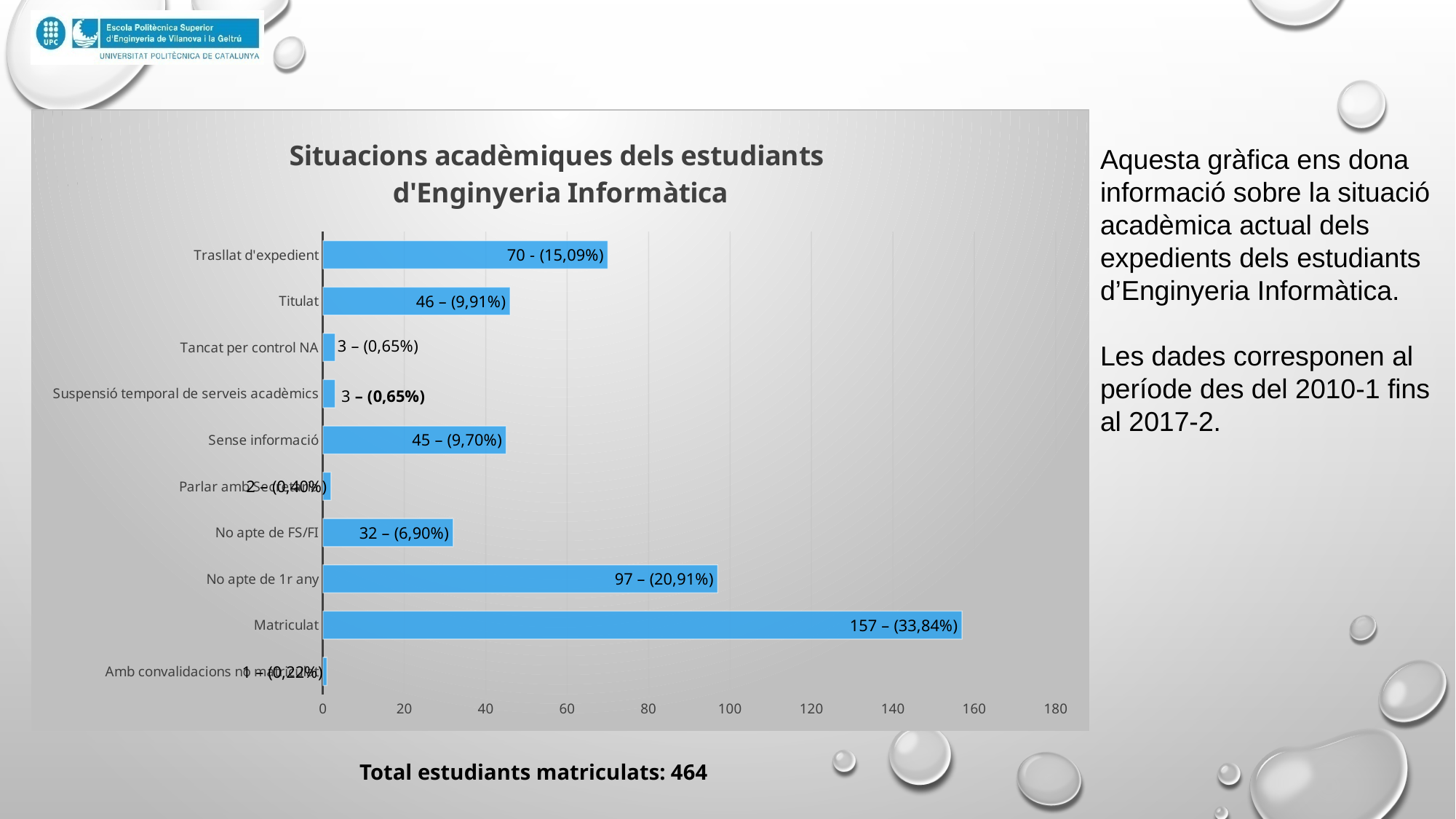
What percentage is shown for 'No apte de 1r any'? 20,91% What is the total number of enrolled students stated below the chart? 464 Which is larger, the value for 'Trasllat d'expedient' or for 'Titulat'? Trasllat d'expedient What is the value for 'No apte de FS/FI'? 32 How many students are in the 'Matriculat' category? 157 What percentage is shown for 'Titulat'? 9,91% What is the title of the chart? Situacions acadèmiques dels estudiants d'Enginyeria Informàtica What kind of chart is shown on the slide? bar chart How many categories are shown in the chart? 10 What is the difference between the values for 'Matriculat' and 'No apte de 1r any'? 60 Which category has the highest value? Matriculat What is the value for 'Trasllat d'expedient'? 70